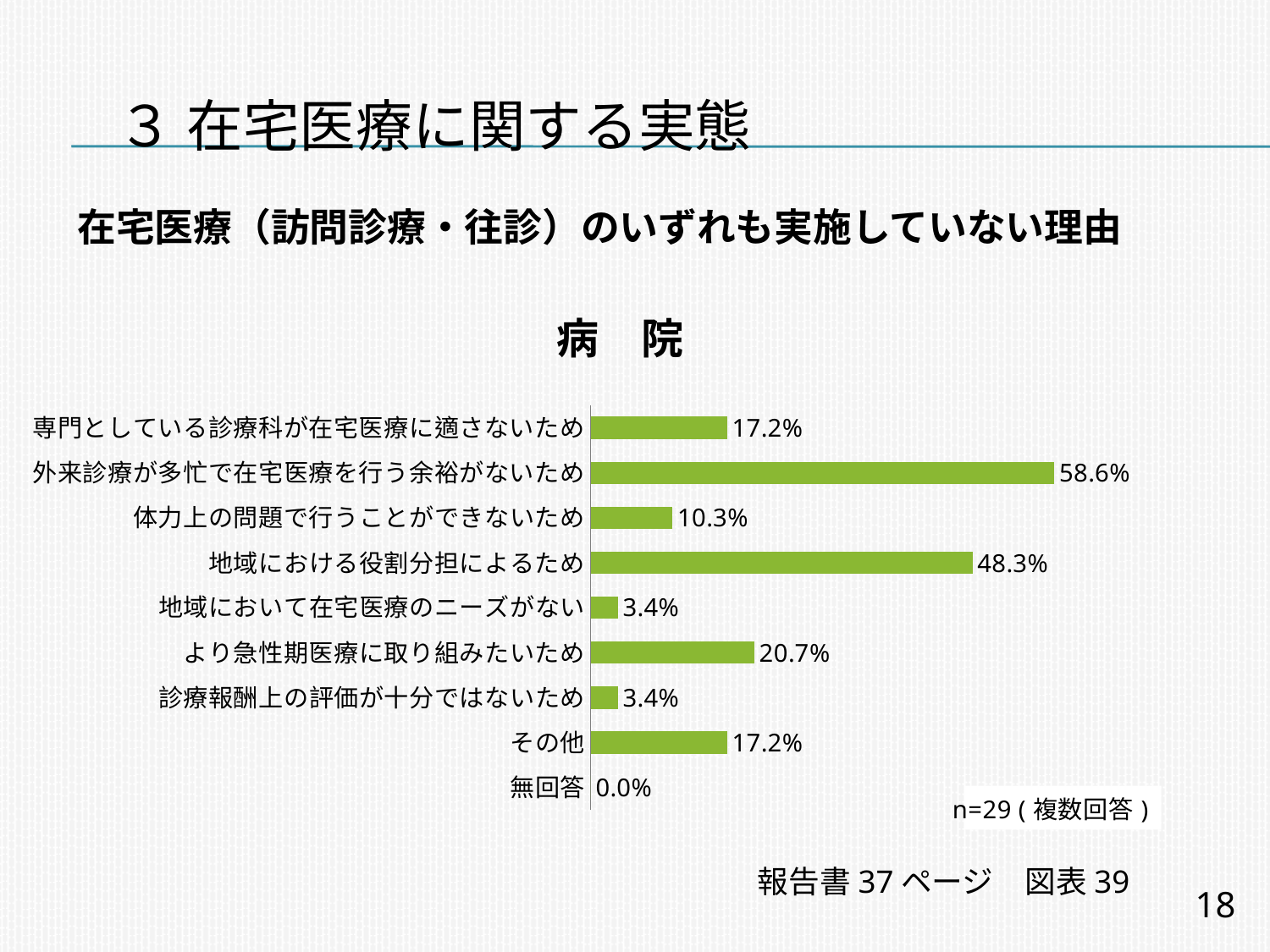
What is the sample size (n) shown on the slide? n=29 What kind of chart is shown on the slide? Bar chart How many categories are shown in the chart? 9 What is the difference between the values for 外来診療が多忙で在宅医療を行う余裕がないため and 地域における役割分担によるため? 10.3% What is the value for 地域における役割分担によるため? 48.3% Which is larger, the value for 専門としている診療科が在宅医療に適さないため or the value for より急性期医療に取り組みたいため? より急性期医療に取り組みたいため Which category has the lowest value? 無回答 What is the value for 外来診療が多忙で在宅医療を行う余裕がないため? 58.6% What is the value for 体力上の問題で行うことができないため? 10.3% Which category has the highest value? 外来診療が多忙で在宅医療を行う余裕がないため What is the title of the chart? 病 院 What is the value for より急性期医療に取り組みたいため? 20.7%